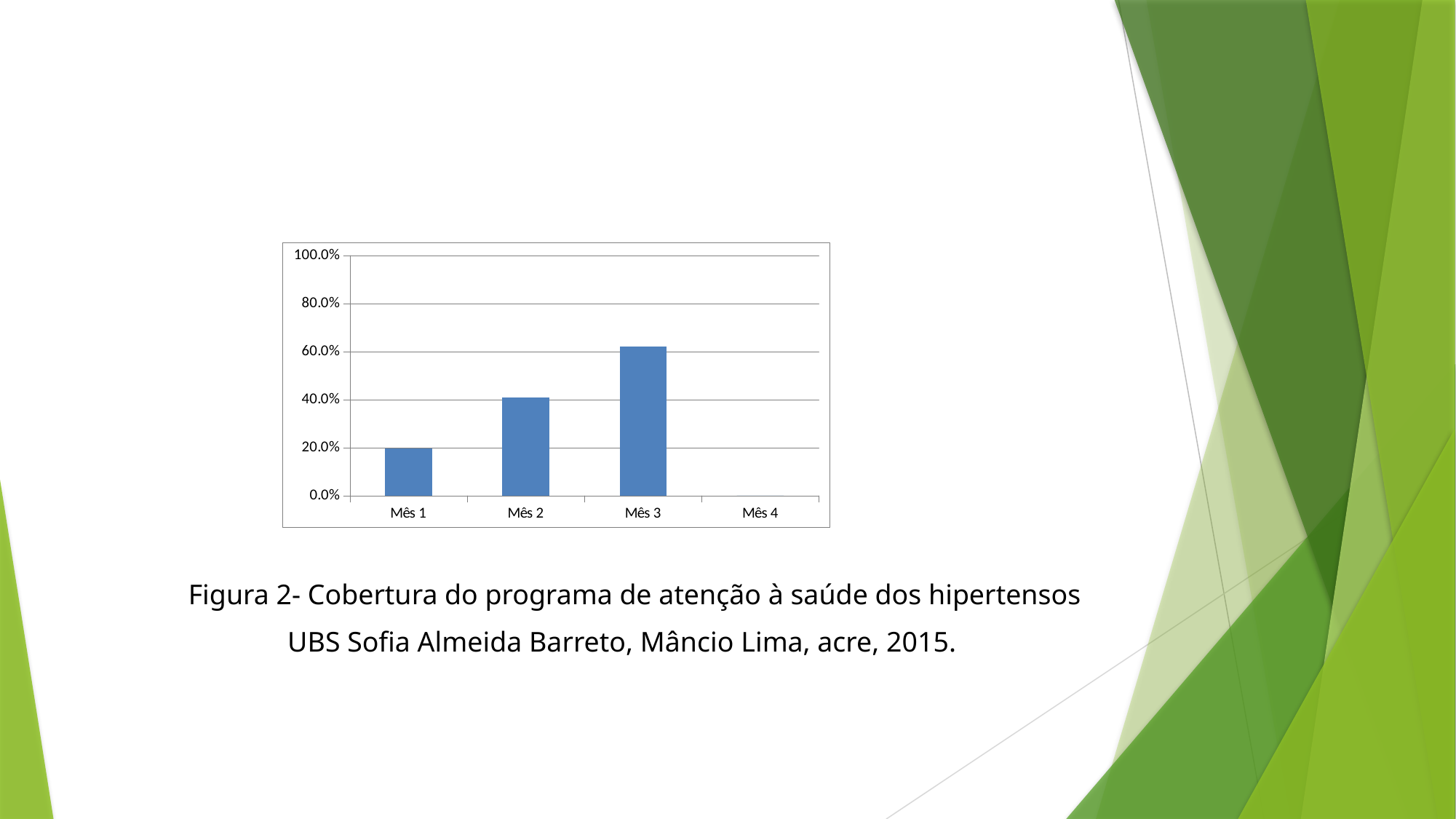
Do the values rise or fall from Mês 1 to Mês 3? rise What kind of chart is shown on the slide? bar chart Is the value for Mês 3 greater or less than 80.0%? less What is the highest value shown on the chart's vertical axis? 100.0% Which is larger, the value for Mês 2 or the value for Mês 1? Mês 2 Is the value for Mês 3 greater or less than 40.0%? greater How many categories are shown on the x axis of the chart? 4 Which month has the lowest value in the chart? Mês 4 Which month has the highest value in the chart? Mês 3 Is the value for Mês 1 greater or less than 40.0%? less Which is larger, the value for Mês 1 or the value for Mês 3? Mês 3